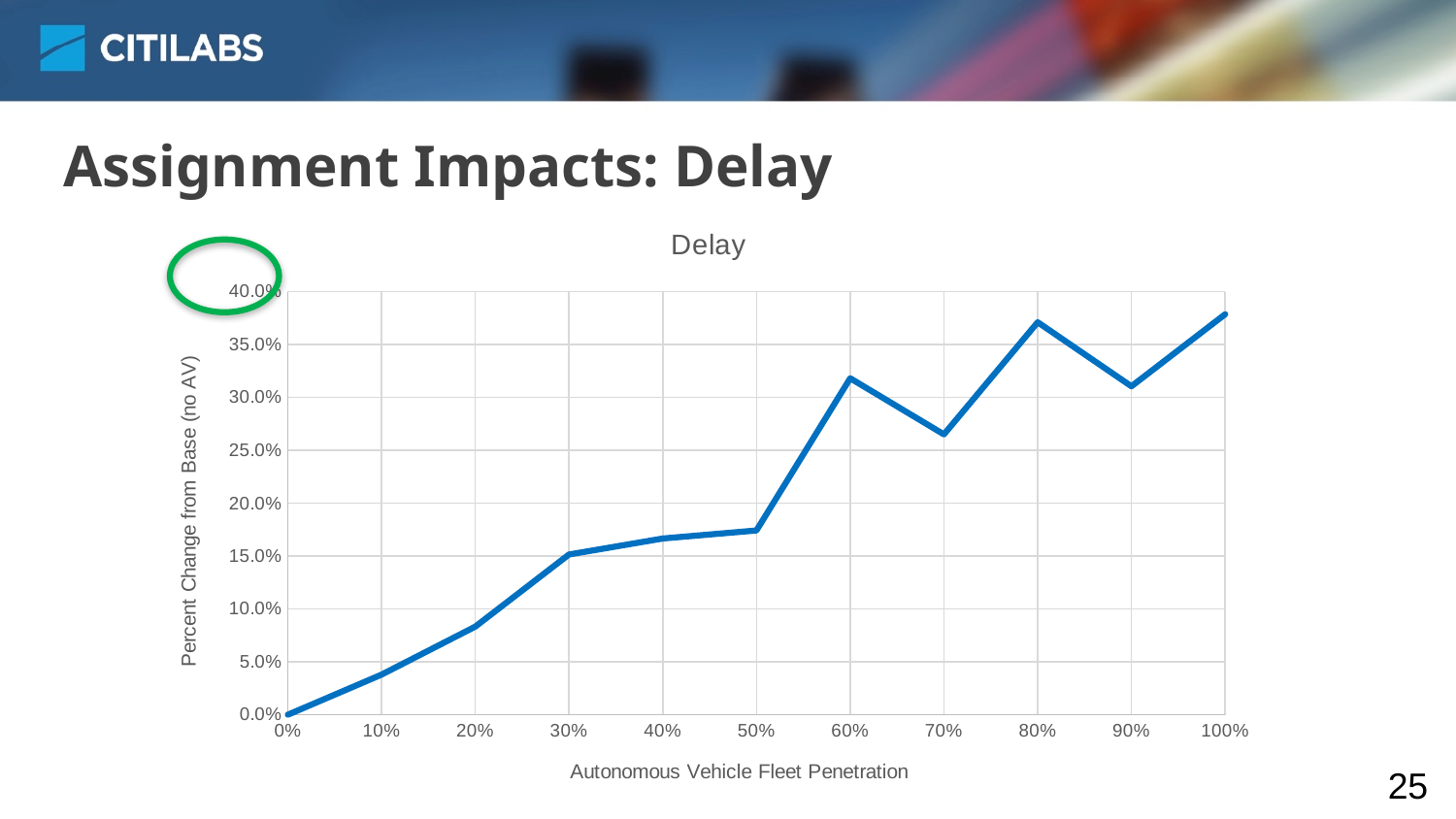
Which has a larger percent change from base: 80% or 90% fleet penetration? 80% What is the title of the chart? Delay Which has a larger percent change from base: 60% or 70% fleet penetration? 60% Is the percent change from base at 80% fleet penetration greater or less than 35.0%? greater What is the percent change from base at 0% fleet penetration? 0.0% Is the percent change from base at 60% fleet penetration greater or less than 30.0%? greater What is the label of the x axis? Autonomous Vehicle Fleet Penetration Overall, does the percent change from base rise or fall as fleet penetration increases from 0% to 100%? rise At which fleet penetration level is the percent change from base lowest? 0% What kind of chart is shown on the slide? line chart How many data points are plotted on the line? 11 Is the percent change from base at 30% fleet penetration greater or less than 20.0%? less